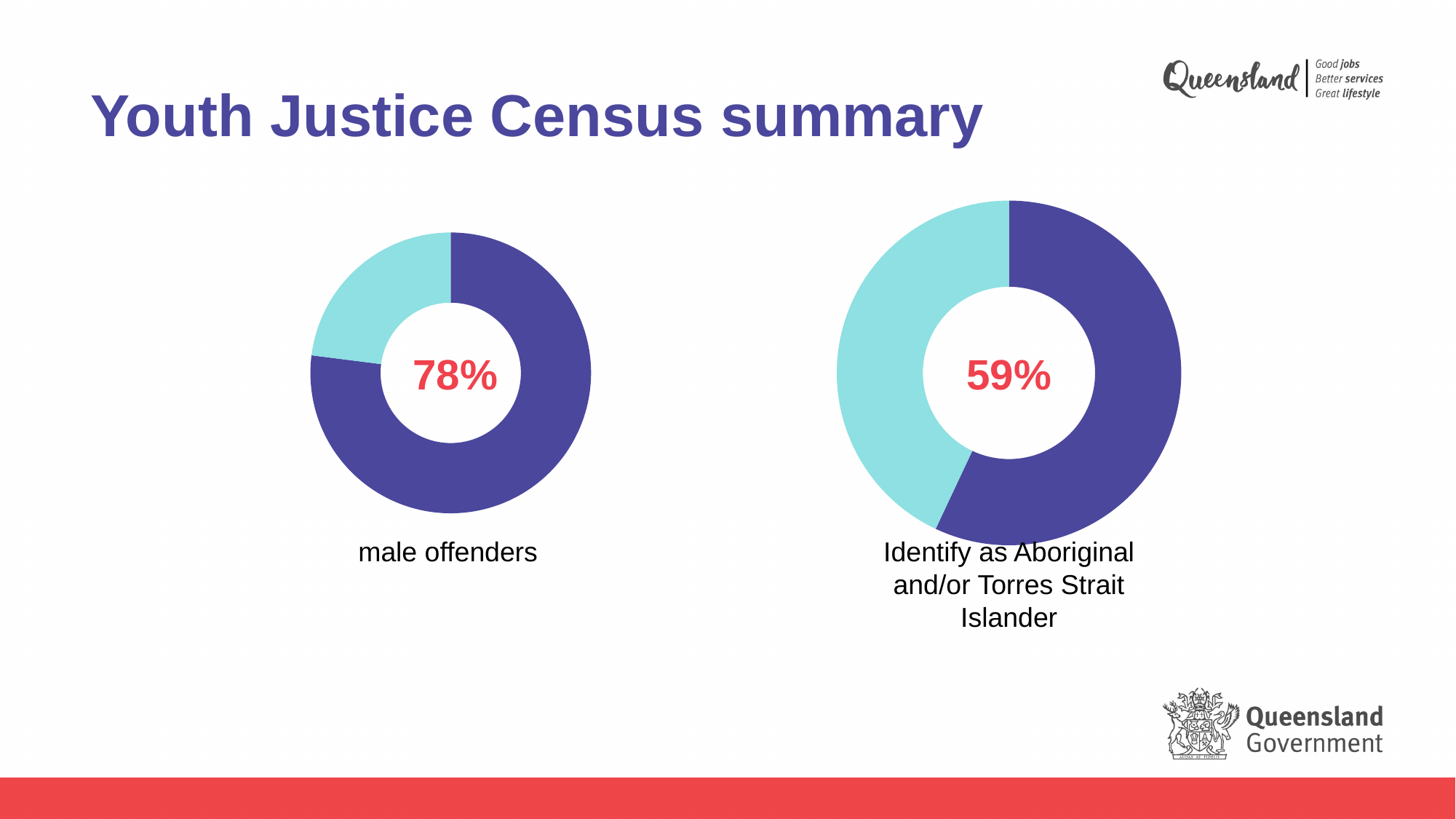
How many charts are shown on the slide? 2 What is the title of the slide containing the two donut charts? Youth Justice Census summary In the right donut chart, what percentage of young people identify as Aboriginal and/or Torres Strait Islander? 59% In the left donut chart, what percentage is shown for male offenders? 78% What is the difference between the male offenders percentage and the Aboriginal and/or Torres Strait Islander percentage? 19 percentage points In the left donut chart, is the value for male offenders greater or less than 50%? greater Which is larger: the percentage of male offenders or the percentage identifying as Aboriginal and/or Torres Strait Islander? Male offenders How many slices does each donut chart have? 2 What colour is the slice representing the highlighted percentage in each donut chart? Dark purple What kind of chart is used on this slide? Donut (pie) chart